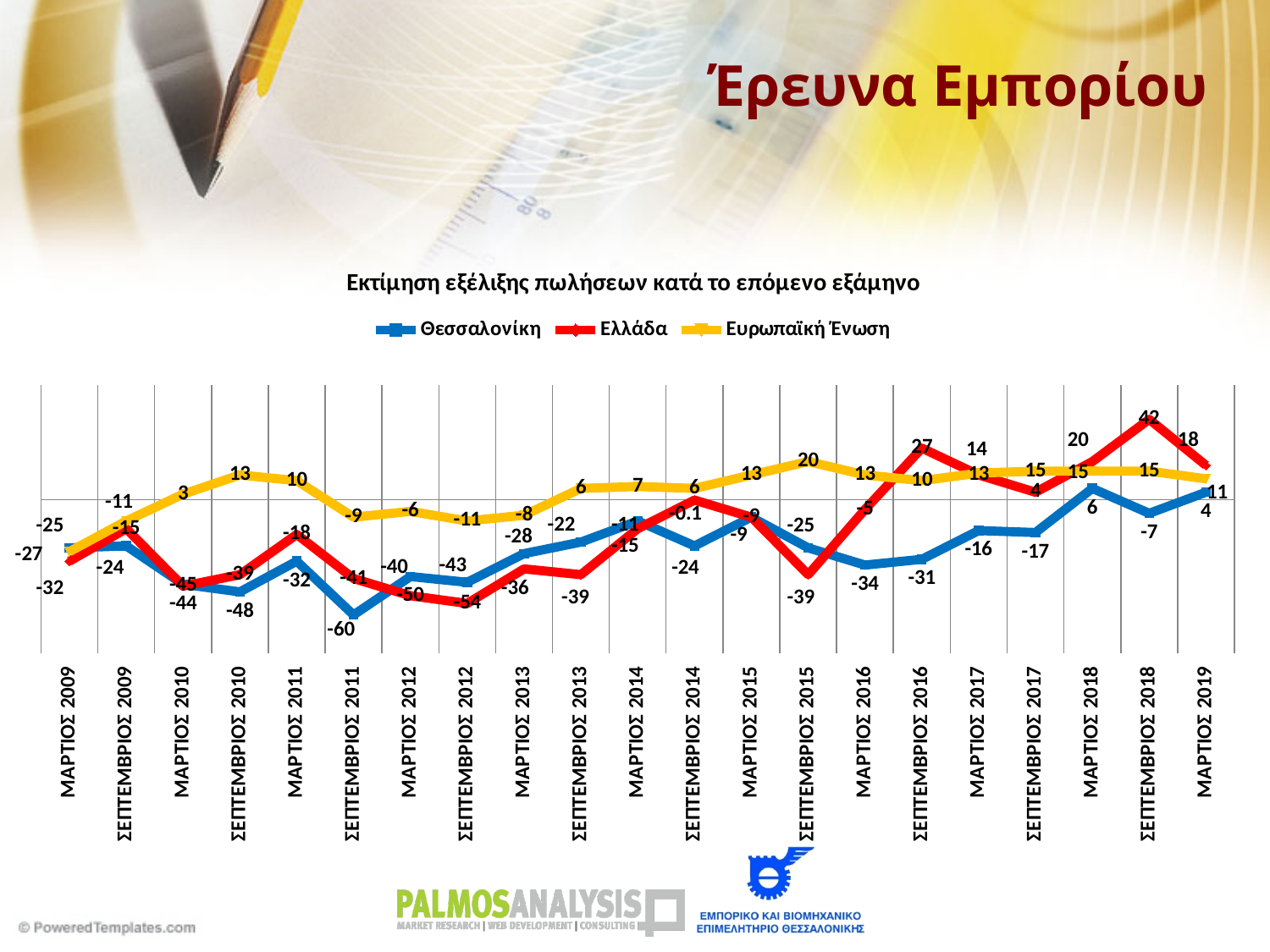
What is the value for Θεσσαλονίκη in ΣΕΠΤΕΜΒΡΙΟΣ 2011? -60 In which period does the Θεσσαλονίκη series reach its lowest value? ΣΕΠΤΕΜΒΡΙΟΣ 2011 In which period does the Ελλάδα series reach its highest value? ΣΕΠΤΕΜΒΡΙΟΣ 2018 How many series does the legend list? 3 In ΣΕΠΤΕΜΒΡΙΟΣ 2016, which series has the larger value, Ελλάδα or Θεσσαλονίκη? Ελλάδα What is the value for Ελλάδα in ΣΕΠΤΕΜΒΡΙΟΣ 2018? 42 How many time points are plotted along the x axis? 21 What is the value for Ευρωπαϊκή Ένωση in ΣΕΠΤΕΜΒΡΙΟΣ 2015? 20 What is the title of the chart? Εκτίμηση εξέλιξης πωλήσεων κατά το επόμενο εξάμηνο What is the difference between the Ελλάδα and Θεσσαλονίκη values in ΜΑΡΤΙΟΣ 2019? 14 What is the value for Θεσσαλονίκη in ΜΑΡΤΙΟΣ 2018? 6 What kind of chart is shown on the slide? Line chart